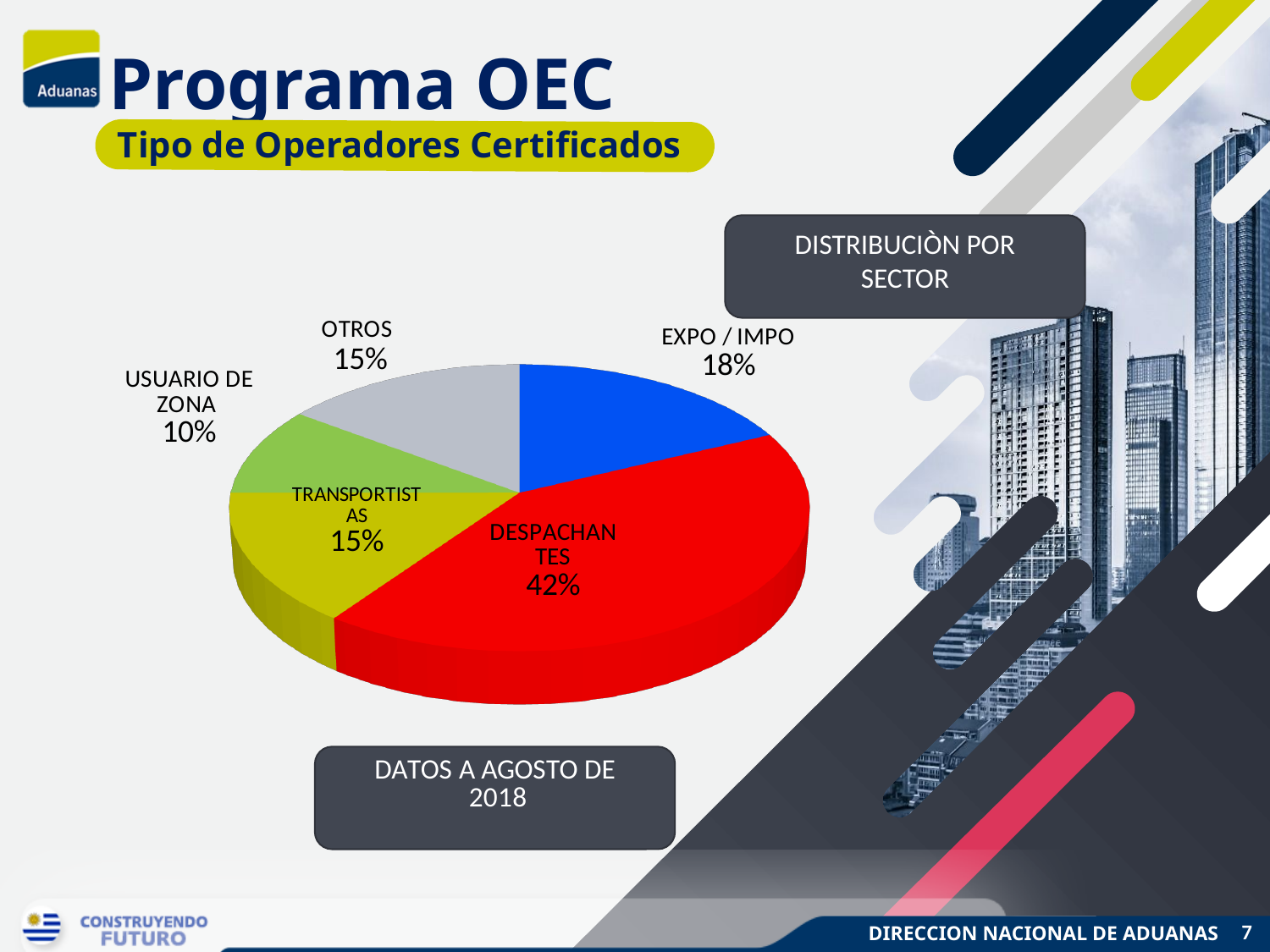
What kind of chart is shown on the slide? pie chart What colour is the DESPACHANTES slice? red What is the difference in percentage points between DESPACHANTES and EXPO / IMPO? 24 What share of the pie does USUARIO DE ZONA hold? 10% What share of the pie does EXPO / IMPO hold? 18% What share of the pie does DESPACHANTES hold? 42% Which is larger, the share for EXPO / IMPO or the share for OTROS? EXPO / IMPO What is the title shown in the box above the pie chart? DISTRIBUCIÒN POR SECTOR Which category has the largest slice of the pie? DESPACHANTES Which category has the smallest slice of the pie? USUARIO DE ZONA How many slices does the pie chart have? 5